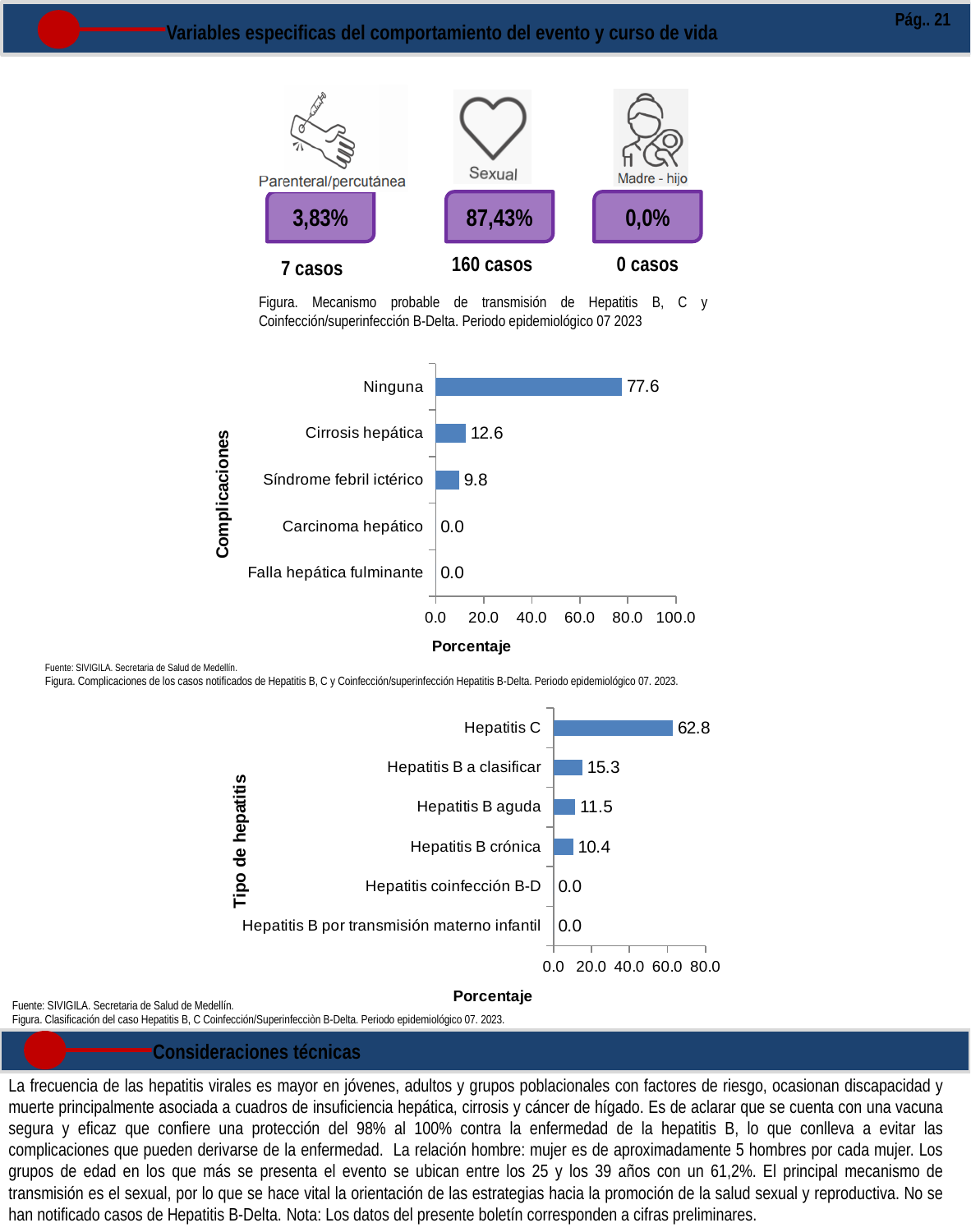
In the upper bar chart (Complicaciones), what is the value for Ninguna? 77.6 What type of chart is the lower chart (Tipo de hepatitis)? Bar chart In the upper bar chart (Complicaciones), how many complication categories are shown? 5 In the lower bar chart (Tipo de hepatitis), which type has the highest percentage? Hepatitis C In the lower bar chart (Tipo de hepatitis), which is larger, Hepatitis B aguda or Hepatitis B crónica? Hepatitis B aguda In the lower bar chart (Tipo de hepatitis), how many categories are shown? 6 In the upper bar chart (Complicaciones), what is the value for Carcinoma hepático? 0.0 In the upper bar chart (Complicaciones), what is the value for Cirrosis hepática? 12.6 In the upper bar chart (Complicaciones), what is the difference between Cirrosis hepática and Síndrome febril ictérico? 2.8 In the upper bar chart (Complicaciones), which complication has the highest percentage? Ninguna In the lower bar chart (Tipo de hepatitis), what is the difference between Hepatitis C and Hepatitis B a clasificar? 47.5 In the lower bar chart (Tipo de hepatitis), what is the value for Hepatitis C? 62.8